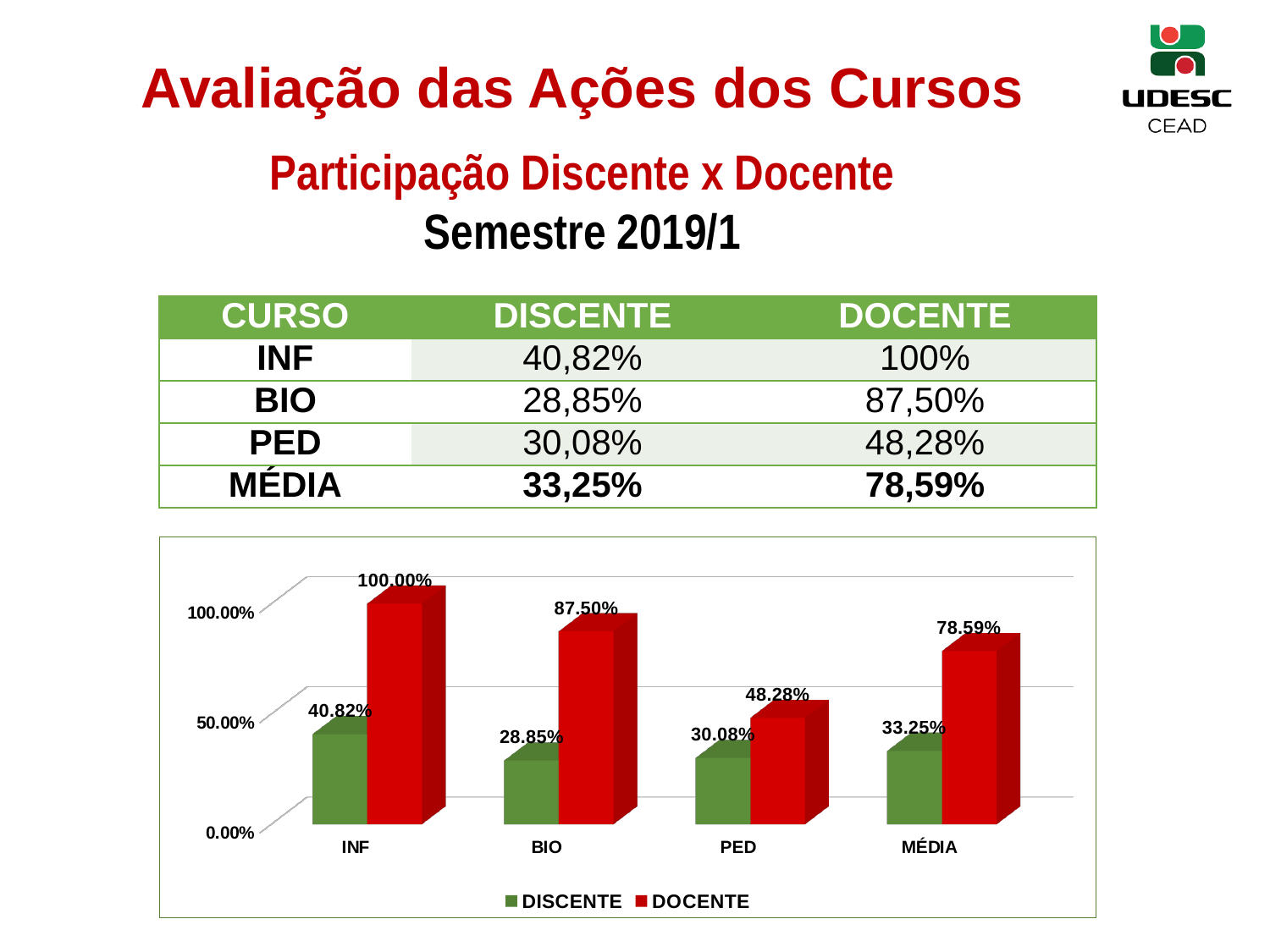
How many series does the chart legend list? 2 Which is larger in the chart: the DISCENTE value for INF or the DISCENTE value for PED? INF Is the DOCENTE value for PED greater or less than 50.00%? less Which category has the highest DOCENTE value in the chart? INF What is the DISCENTE value for PED in the chart? 30.08% What is the difference between the DOCENTE values for INF and BIO in the chart? 12.50% Which category has the lowest DISCENTE value in the chart? BIO How many categories are shown on the x axis of the chart? 4 What is the difference between the DOCENTE and DISCENTE values for PED in the chart? 18.20% What is the DISCENTE value for MÉDIA in the chart? 33.25% What kind of chart is shown on the slide? bar chart What is the DOCENTE value for BIO in the chart? 87.50%